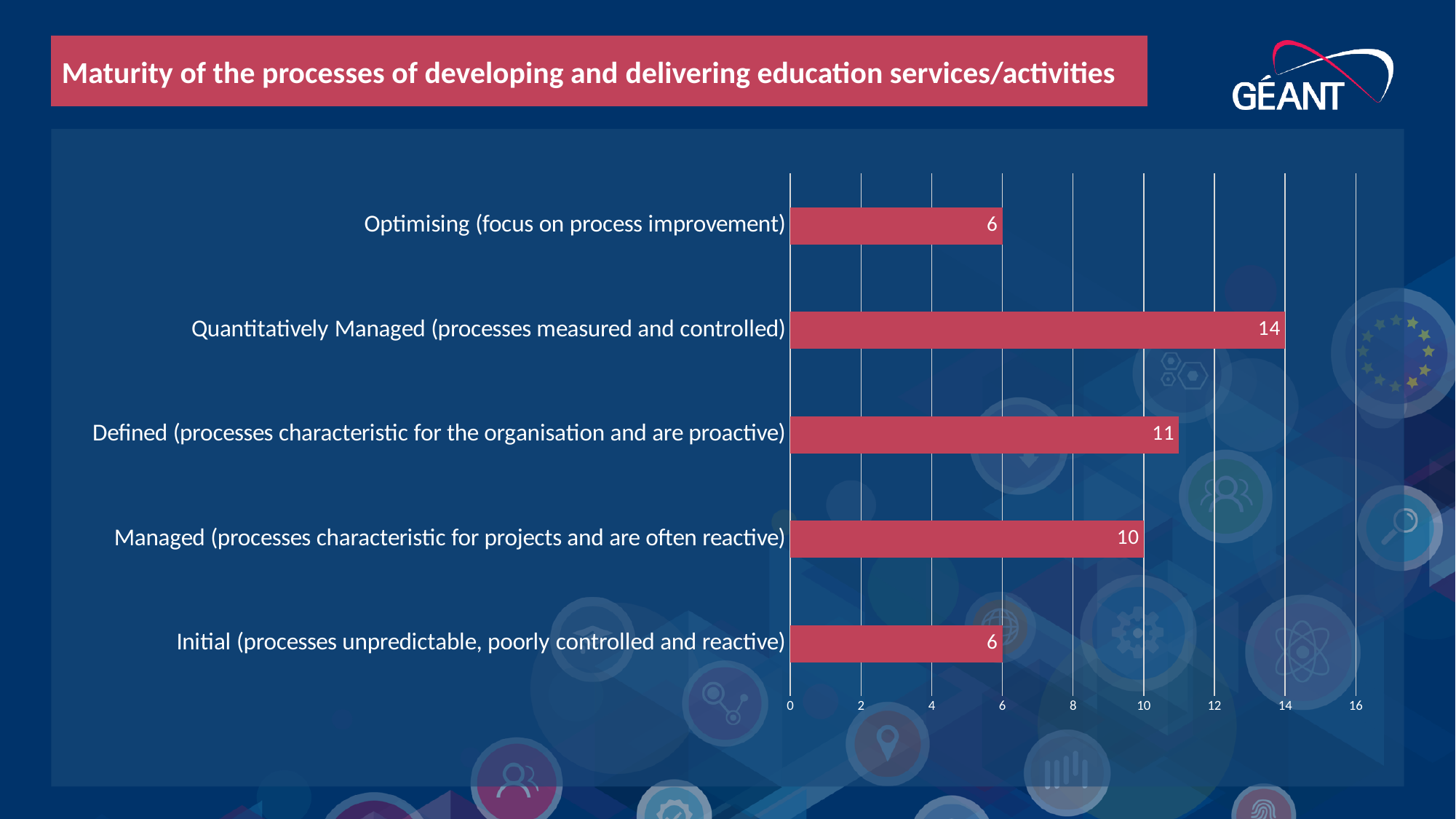
What kind of chart is shown on the slide? Bar chart How many maturity levels are shown in the chart? 5 What is the difference between the values for Quantitatively Managed and Defined? 3 What is the value for Quantitatively Managed (processes measured and controlled)? 14 Which is larger, the value for Defined or the value for Managed? Defined Which maturity level has the highest value? Quantitatively Managed (processes measured and controlled) What is the difference between the values for Managed and Initial? 4 Is the value for Quantitatively Managed greater or less than 12? greater What is the value for Managed (processes characteristic for projects and are often reactive)? 10 What is the value for Defined (processes characteristic for the organisation and are proactive)? 11 What is the title of the slide? Maturity of the processes of developing and delivering education services/activities What is the value for Initial (processes unpredictable, poorly controlled and reactive)? 6